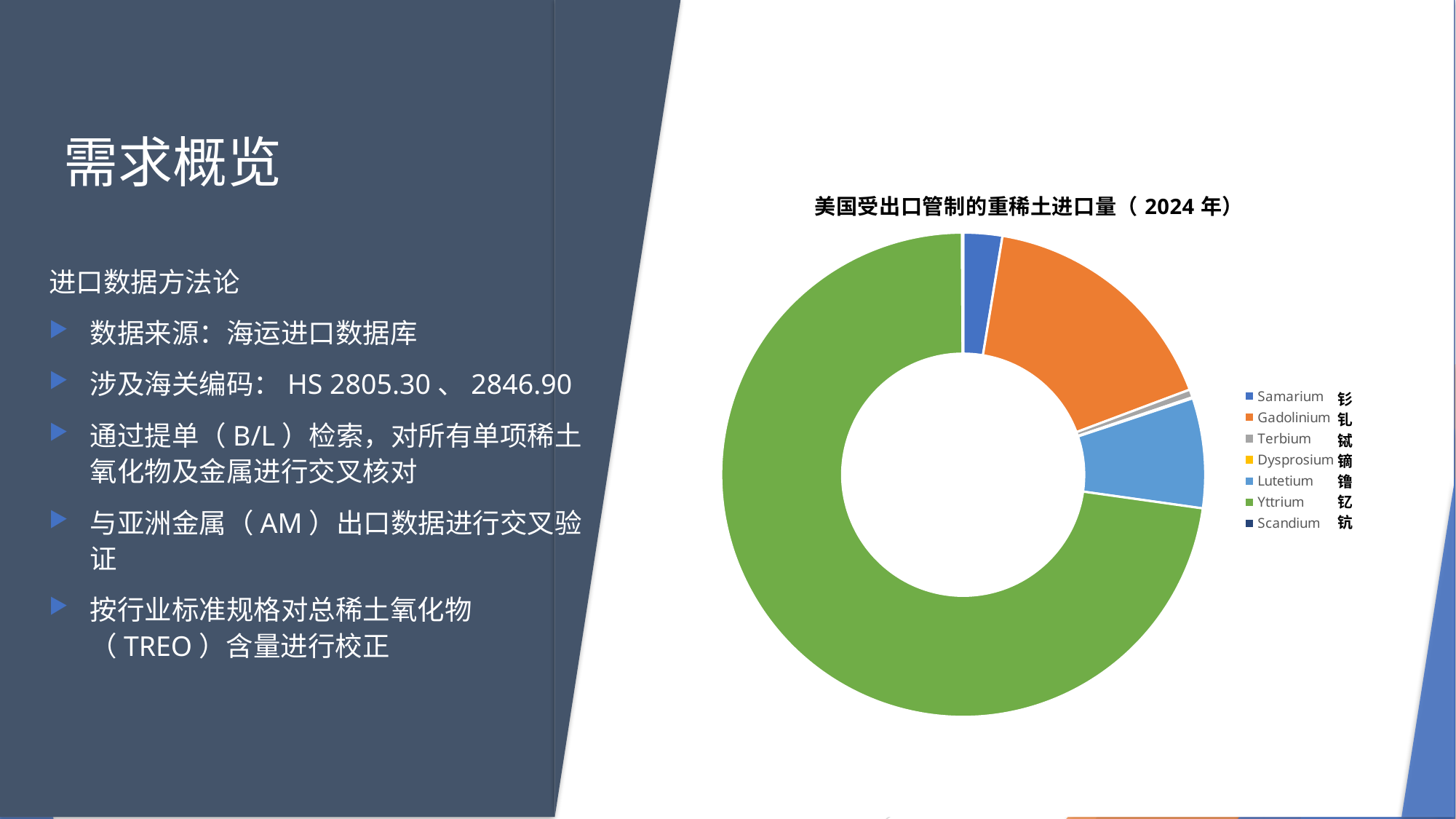
Which is larger, the slice for Gadolinium or the slice for Lutetium? Gadolinium Which element has the second-largest slice in the chart? Gadolinium What kind of chart is shown on the slide? Doughnut (pie) chart Which is larger, the slice for Lutetium or the slice for Samarium? Lutetium How many entries does the chart's legend list? 7 What colour is the Yttrium slice in the chart? Green Which element accounts for the largest share of the chart? Yttrium What is the title of the chart? 美国受出口管制的重稀土进口量（2024年）